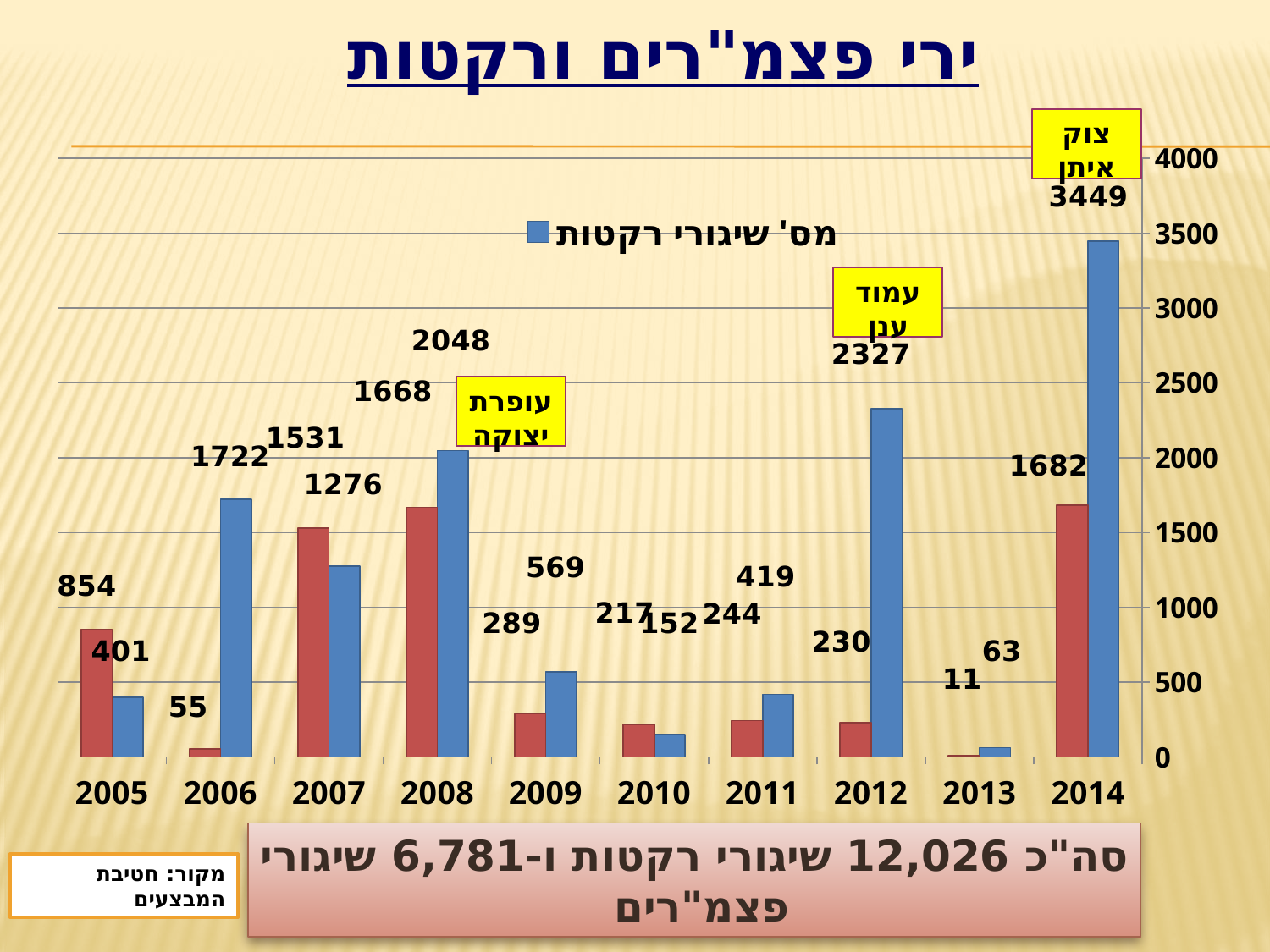
Is the blue bar value for 2006 greater or less than 1500? greater What is the value of the red bar for 2013? 11 What is the value of the red bar for 2005? 854 What is the sum of the red and blue bar values for 2014? 5131 In 2007, which bar is larger, the red bar or the blue bar? the red bar What kind of chart is shown on the slide? bar chart How many years are shown on the x axis? 10 What is the difference between the blue bar values for 2014 and 2012? 1122 How many series does the legend list? 1 In which year is the blue bar (מס' שיגורי רקטות) lowest? 2013 What is the value of the blue bar (מס' שיגורי רקטות) for 2014? 3449 In which year is the blue bar (מס' שיגורי רקטות) highest? 2014